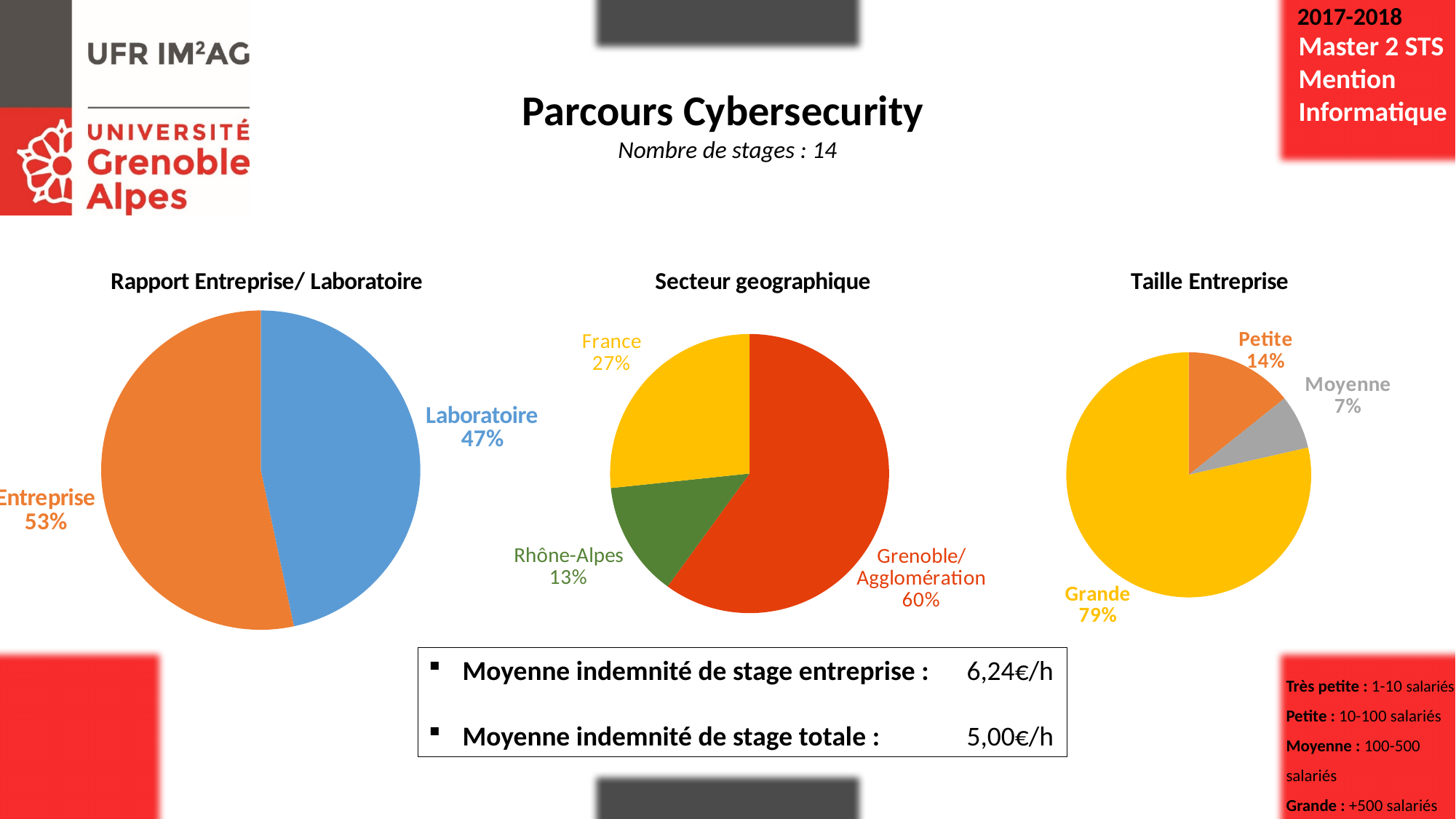
What type of chart is the 'Taille Entreprise' chart? Pie chart In the 'Secteur geographique' chart, what share is Rhône-Alpes? 13% How many slices does the 'Secteur geographique' chart have? 3 In the 'Rapport Entreprise/ Laboratoire' chart, which slice is larger, Entreprise or Laboratoire? Entreprise In the 'Rapport Entreprise/ Laboratoire' chart, what share is Laboratoire? 47% In the 'Taille Entreprise' chart, what is the difference between the Petite share and the Moyenne share? 7% In the 'Secteur geographique' chart, what is the difference between the France share and the Rhône-Alpes share? 14% In the 'Taille Entreprise' chart, which category has the largest share? Grande In the 'Secteur geographique' chart, which category has the smallest share? Rhône-Alpes In the 'Rapport Entreprise/ Laboratoire' chart, what share is Entreprise? 53%